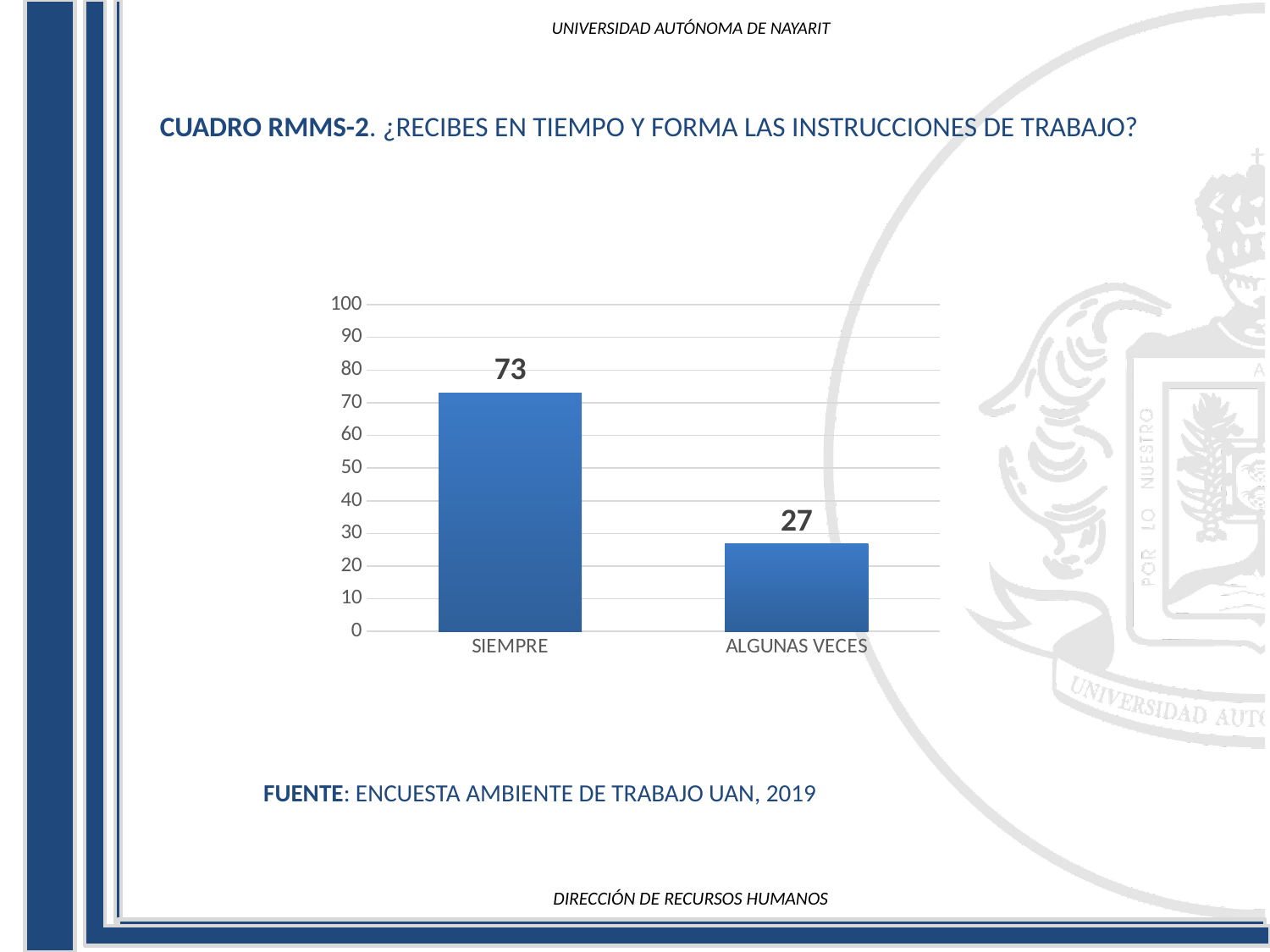
What is the maximum value shown on the vertical axis? 100 Is the value for ALGUNAS VECES greater or less than 30? less Which category has the lowest value? ALGUNAS VECES Which is larger, the value for SIEMPRE or the value for ALGUNAS VECES? SIEMPRE Which category has the highest value? SIEMPRE What kind of chart is shown on the slide? Bar chart What is the value for SIEMPRE? 73 Is the value for SIEMPRE greater or less than 50? greater What is the value for ALGUNAS VECES? 27 What is the difference between the values for SIEMPRE and ALGUNAS VECES? 46 How many categories are shown in the chart? 2 What is the total of the two values shown in the chart? 100